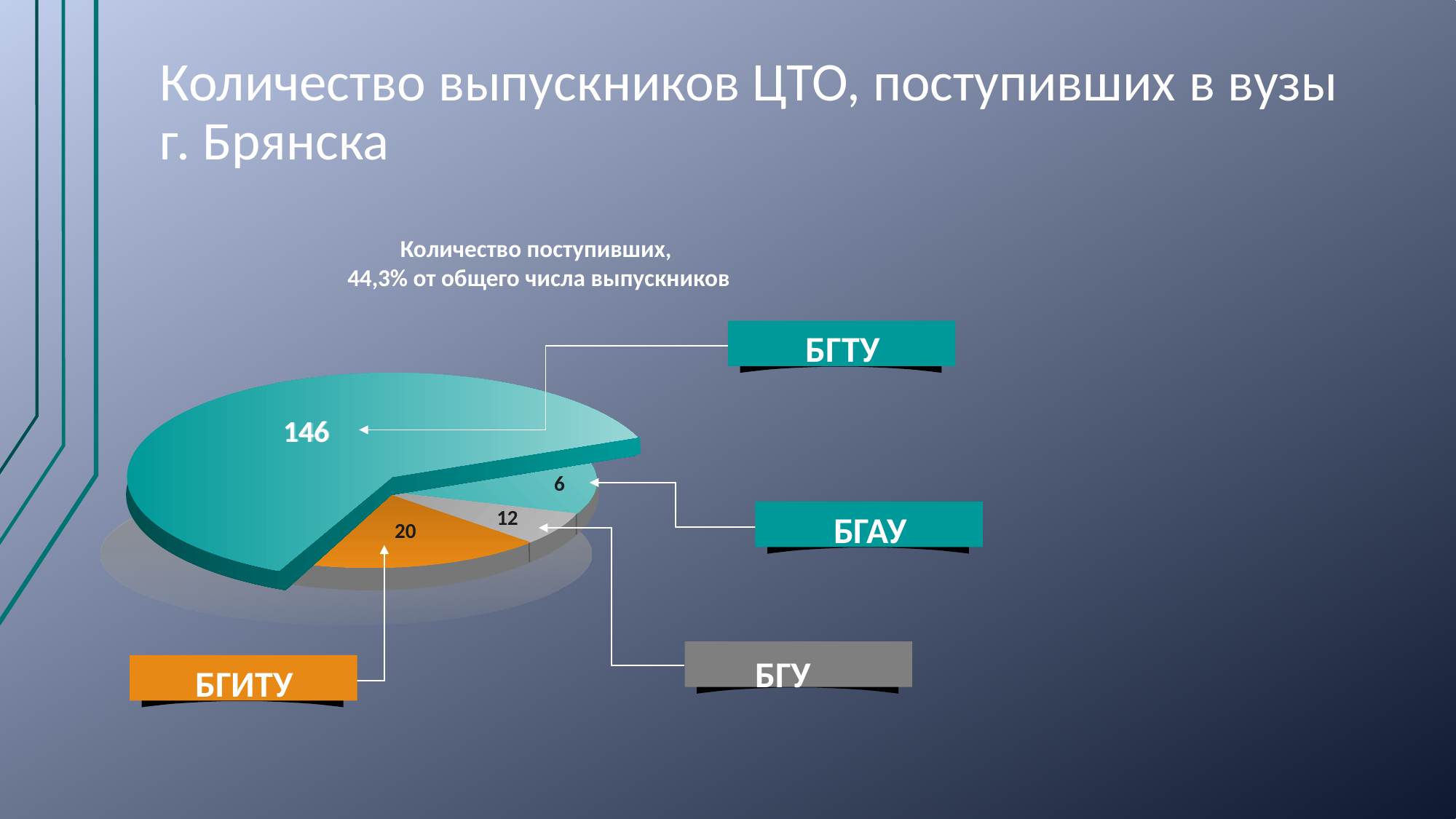
How many slices does the pie chart have? 4 Which university has the smallest slice? БГАУ What is the value for БГУ? 12 What is the title of the chart? Количество поступивших, 44,3% от общего числа выпускников What is the value for БГИТУ? 20 What is the difference between the values for БГТУ and БГИТУ? 126 What is the value for БГАУ? 6 Which is larger, the value for БГУ or the value for БГАУ? БГУ What is the total of all slices in the pie chart? 184 What is the value for БГТУ? 146 What kind of chart is shown on the slide? pie chart Which university has the largest slice? БГТУ